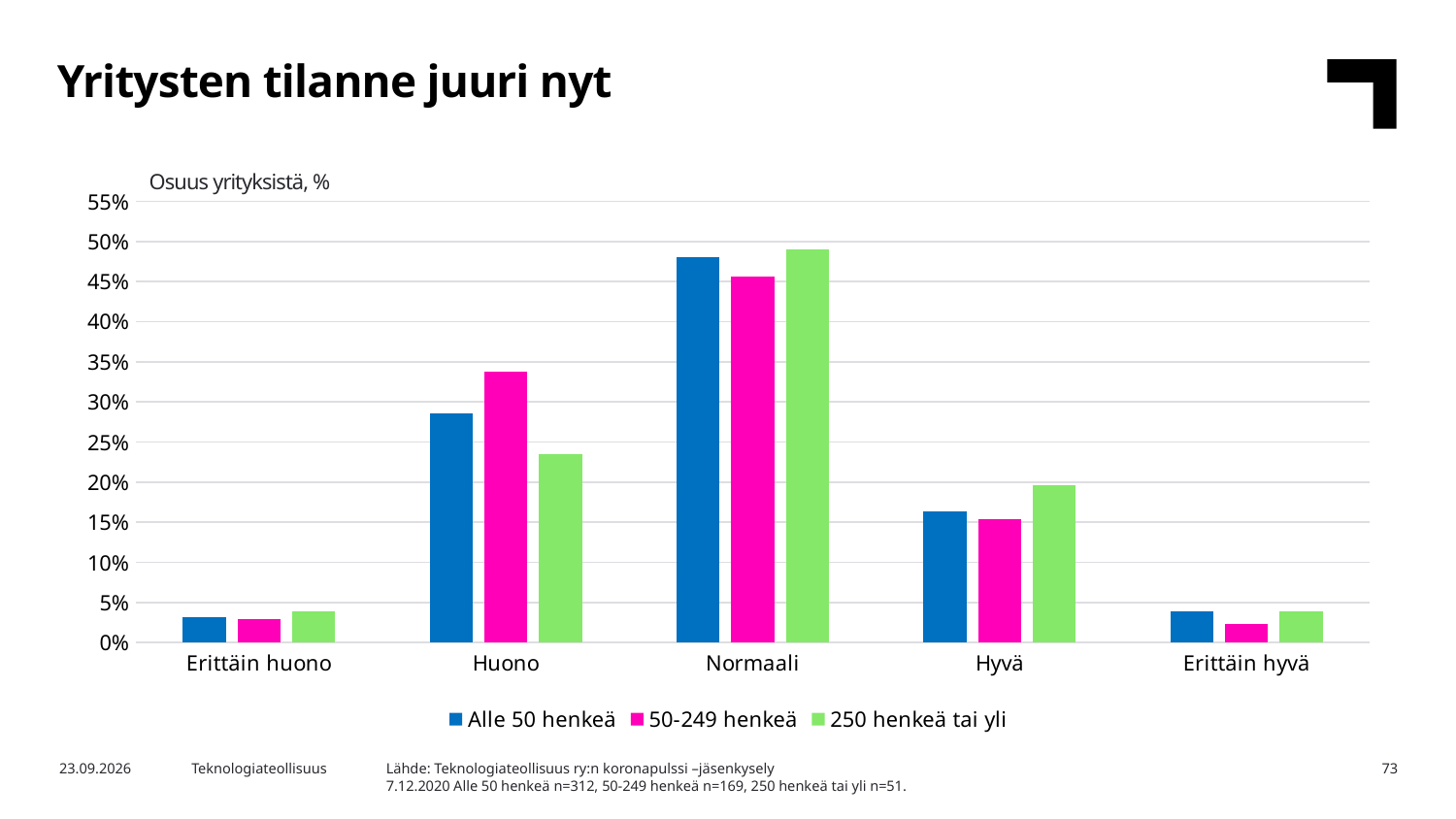
Is the value for 'Huono' in the series '50-249 henkeä' greater or less than 30%? greater Which category has the highest value for the series 'Alle 50 henkeä'? Normaali Which category has the highest value for the series '50-249 henkeä'? Normaali For the category 'Hyvä', which series has the larger value: '50-249 henkeä' or '250 henkeä tai yli'? 250 henkeä tai yli For the category 'Huono', which series has the larger value: 'Alle 50 henkeä' or '250 henkeä tai yli'? Alle 50 henkeä What is the label shown above the y axis of the chart? Osuus yrityksistä, % How many series does the legend list? 3 Is the value for 'Normaali' in the series 'Alle 50 henkeä' greater or less than 45%? greater How many categories are shown on the x axis? 5 Is the value for 'Huono' in the series '250 henkeä tai yli' greater or less than 25%? less What type of chart is shown on the slide? Bar chart What colour represents the series '250 henkeä tai yli' in the legend? Green